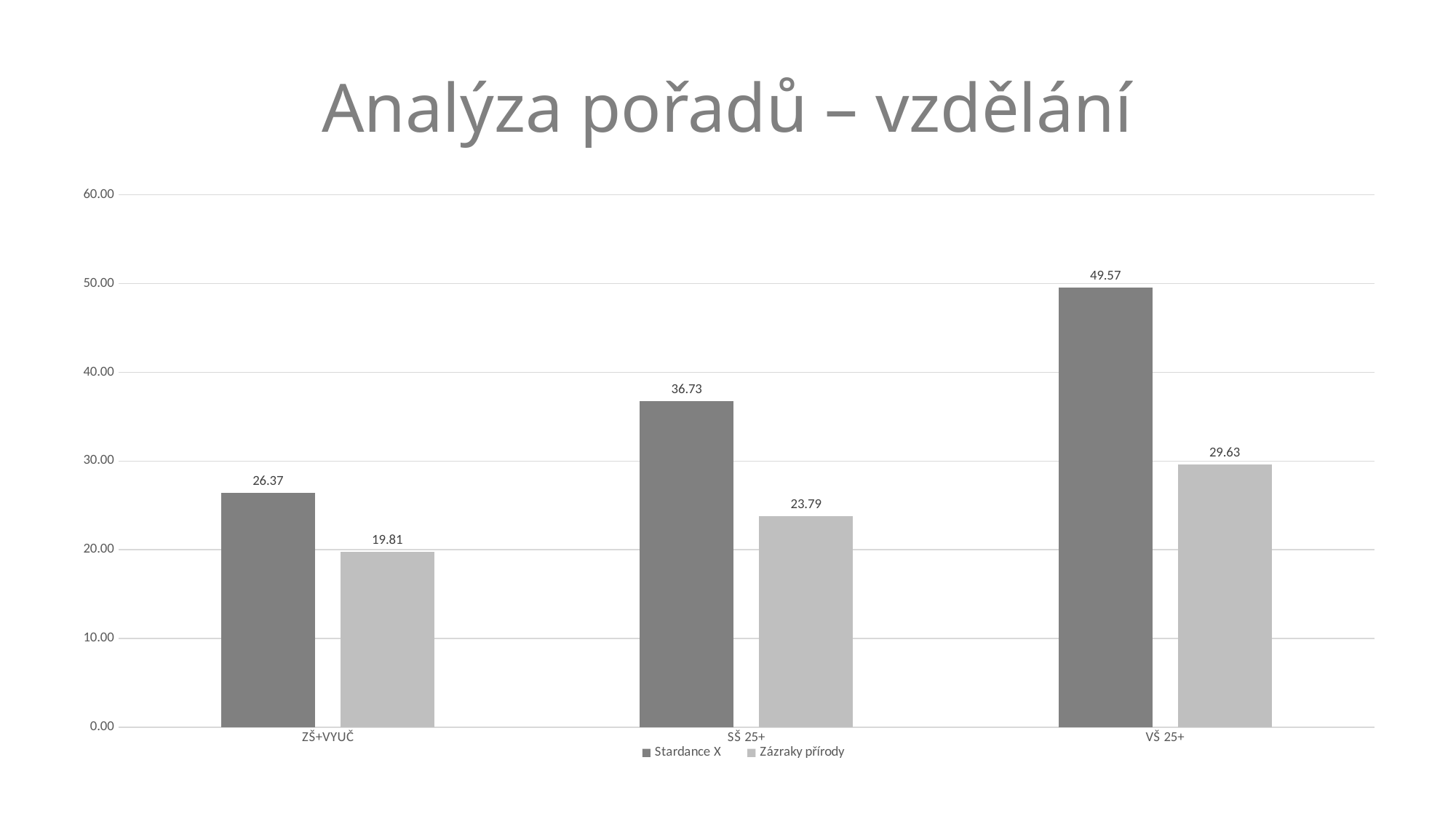
What is the value for Zázraky přírody in the ZŠ+VYUČ category? 19.81 How many series does the legend list? 2 Do the values for Stardance X rise or fall from ZŠ+VYUČ to VŠ 25+? rise What is the value for Zázraky přírody in the SŠ 25+ category? 23.79 What is the difference between Stardance X and Zázraky přírody in the VŠ 25+ category? 19.94 Which series has the larger value in the SŠ 25+ category, Stardance X or Zázraky přírody? Stardance X Is the value for Stardance X in the ZŠ+VYUČ category greater or less than 30.00? less How many categories are shown on the x axis? 3 What kind of chart is shown on the slide? bar chart Which category has the highest value for Stardance X? VŠ 25+ What is the value for Stardance X in the VŠ 25+ category? 49.57 Which category has the lowest value for Zázraky přírody? ZŠ+VYUČ